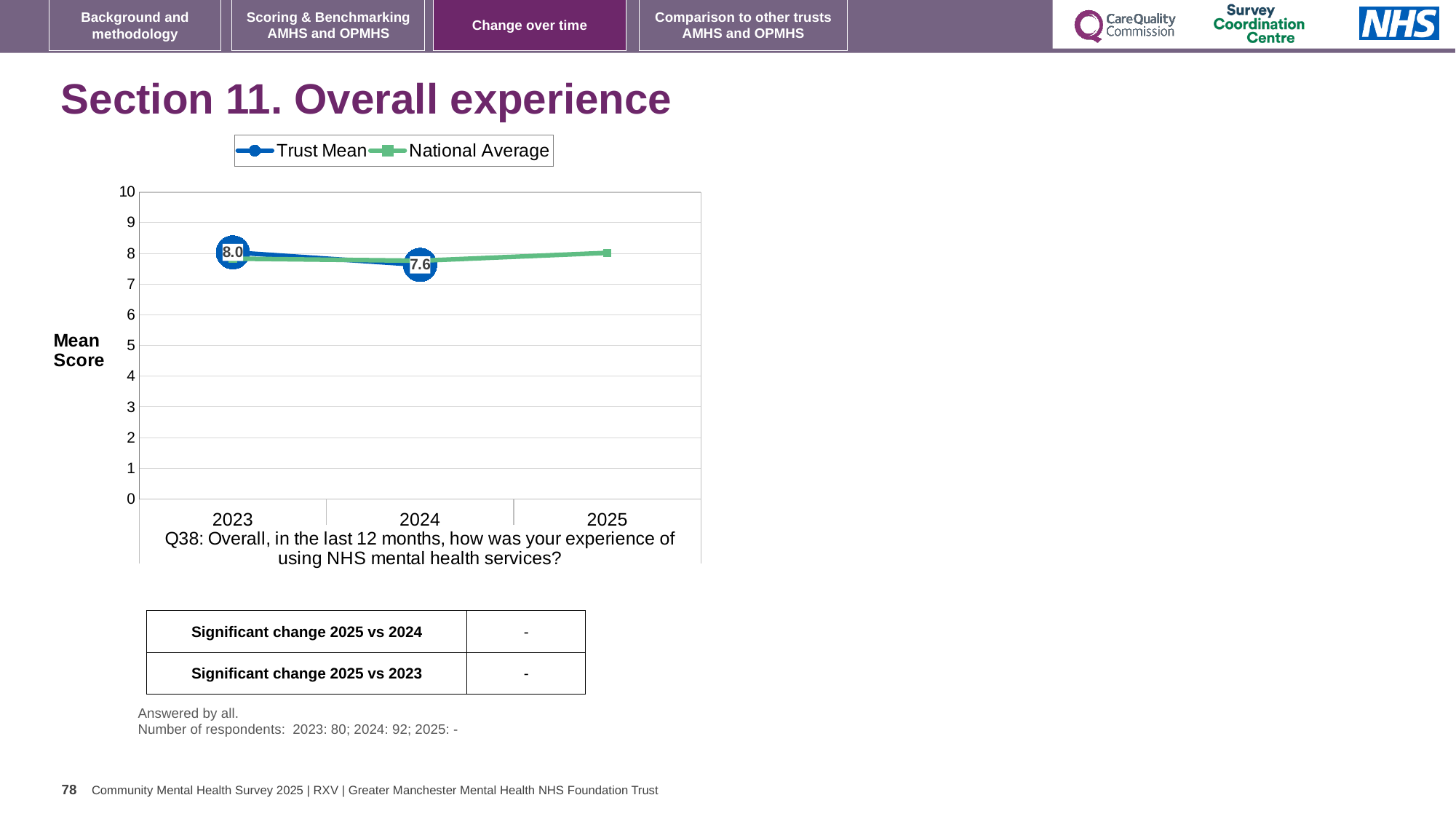
Does the Trust Mean rise or fall from 2023 to 2024? fall In which year is the Trust Mean highest? 2023 What is the Trust Mean value for 2023? 8.0 What is the difference between the Trust Mean in 2023 and in 2024? 0.4 Which year has the higher Trust Mean, 2023 or 2024? 2023 What is the label on the y axis? Mean Score Is the National Average value for 2025 greater or less than 5? greater How many series does the legend list? 2 What kind of chart is shown on the slide? line chart What is the Trust Mean value for 2024? 7.6 How many years are shown on the x axis? 3 What are the two series named in the legend? Trust Mean and National Average